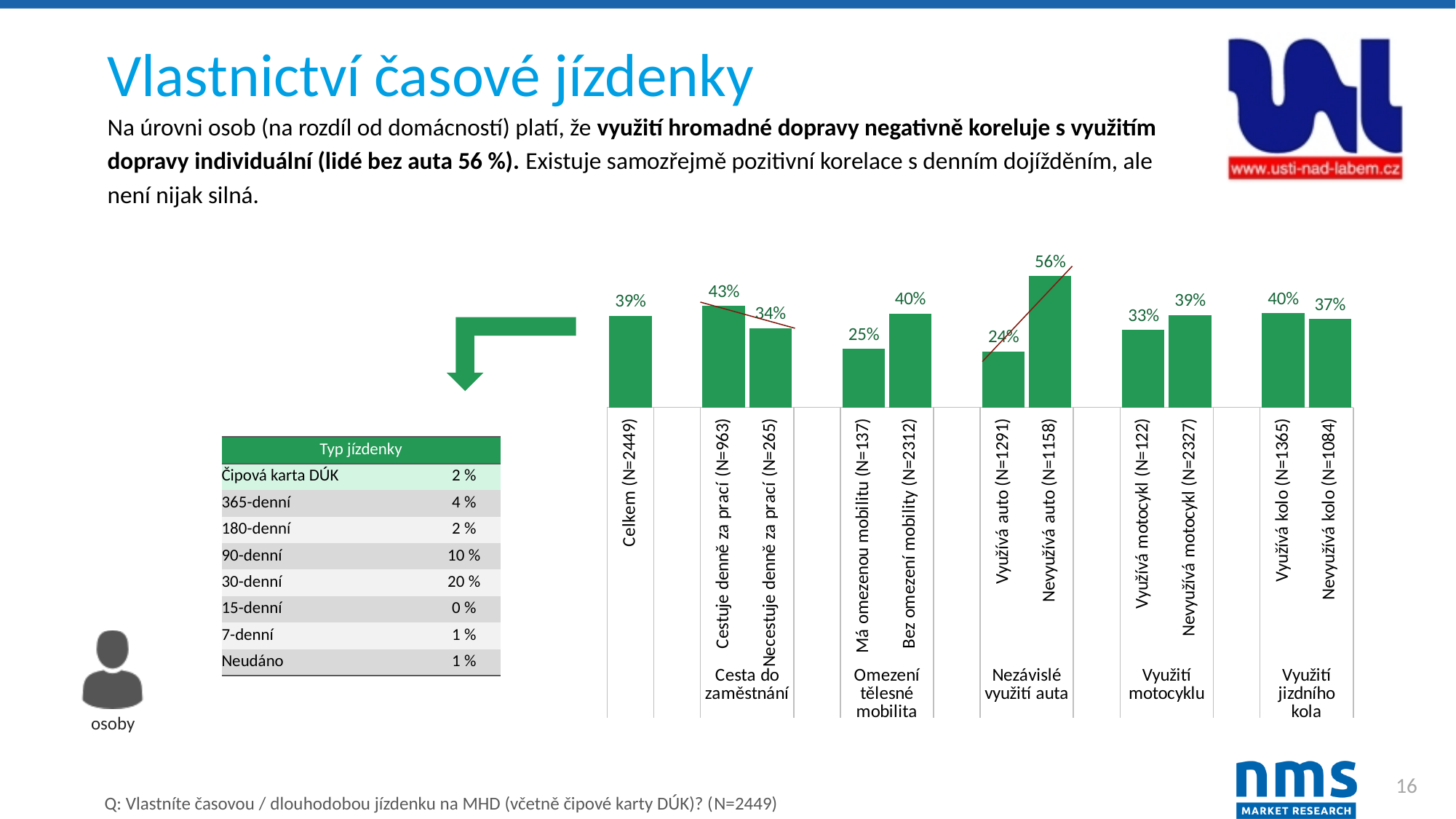
What is the value for Nevyužívá auto (N=1158)? 56% What is the difference between the values for Bez omezení mobility and Má omezenou mobilitu? 15 percentage points Which is larger: the value for Cestuje denně za prací or for Necestuje denně za prací? Cestuje denně za prací How many bars are plotted in the chart? 11 Which category has the highest value in the chart? Nevyužívá auto (N=1158) What is the value for Celkem (N=2449)? 39% What is the value for Má omezenou mobilitu (N=137)? 25% What kind of chart is shown on the slide? bar chart What is the value for Nevyužívá kolo (N=1084)? 37% Which category has the lowest value in the chart? Využívá auto (N=1291) What is the value for Využívá motocykl (N=122)? 33% What is the difference between the values for Nevyužívá auto and Využívá auto? 32 percentage points